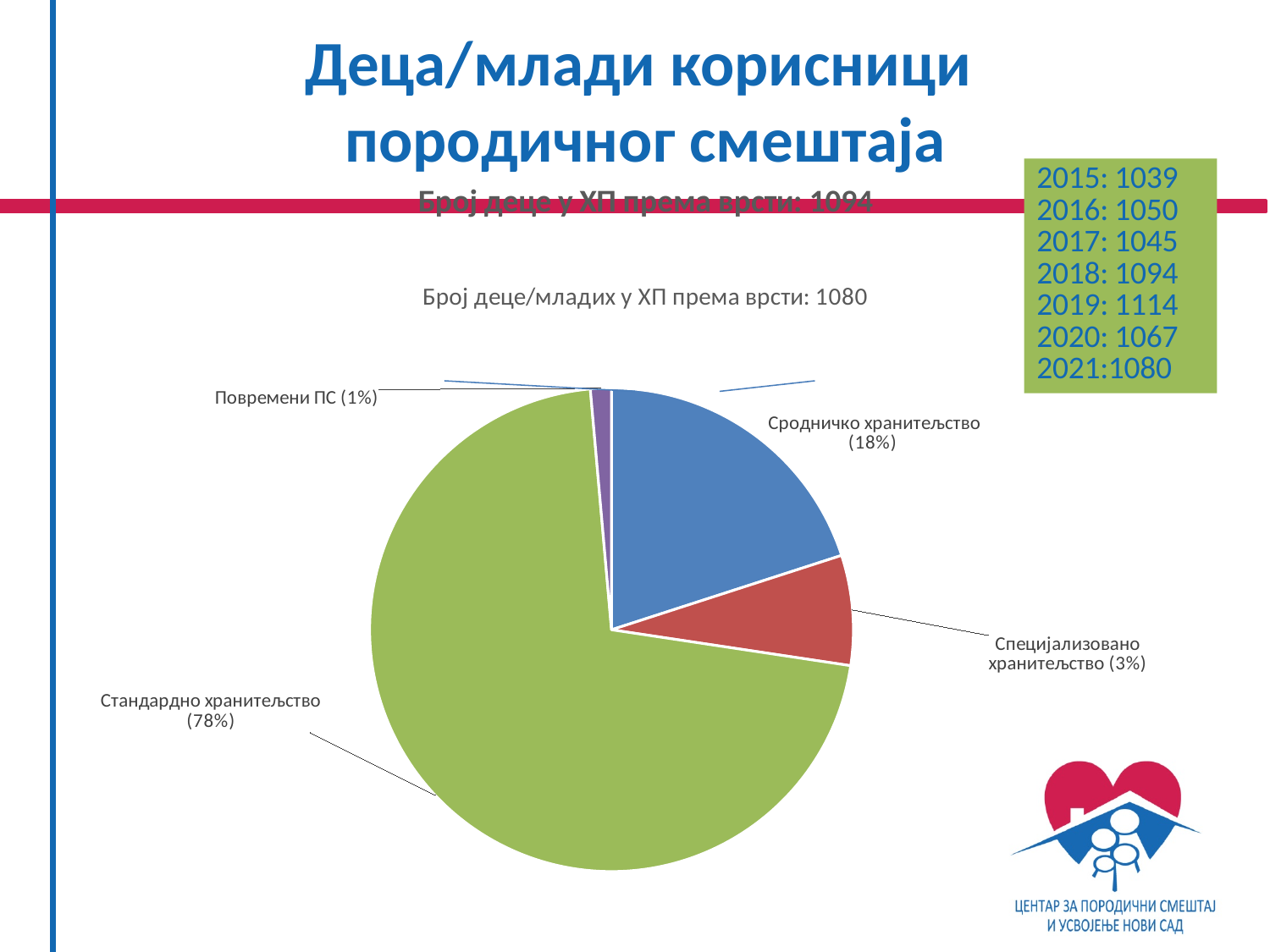
What is the difference in percentage points between Стандардно хранитељство and Сродничко хранитељство? 60 Which category has the smallest slice of the pie? Повремени ПС What share of the pie does Сродничко хранитељство have? 18% What kind of chart is shown on the slide? pie chart What share of the pie does Специјализовано хранитељство have? 3% Which category has the largest slice of the pie? Стандардно хранитељство What share of the pie does Стандардно хранитељство have? 78% What is the title of the pie chart? Број деце/младих у ХП према врсти: 1080 What colour is the slice for Стандардно хранитељство? green Which is larger, the share for Сродничко хранитељство or the share for Специјализовано хранитељство? Сродничко хранитељство How many slices does the pie chart have? 4